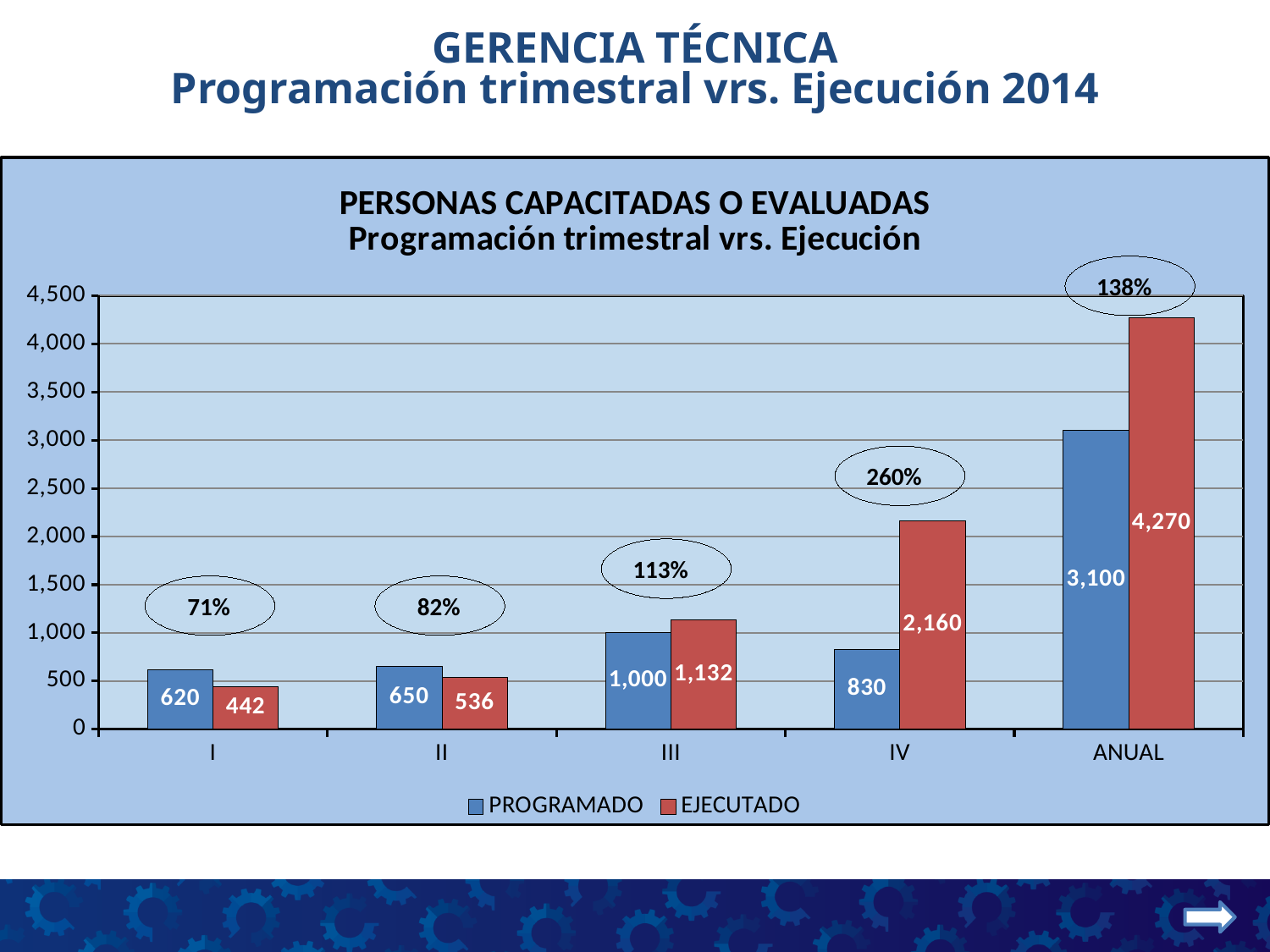
What kind of chart is shown? bar chart Which category has the highest EJECUTADO value? ANUAL For quarter II, which is larger, PROGRAMADO or EJECUTADO? PROGRAMADO What percentage is shown in the oval above quarter IV? 260% How many series does the legend list? 2 How many categories are shown on the x axis? 5 What is the difference between the EJECUTADO and PROGRAMADO values for quarter IV? 1,330 What is the EJECUTADO value for ANUAL? 4,270 What is the PROGRAMADO value for quarter III? 1,000 What is the EJECUTADO value for quarter IV? 2,160 Is the PROGRAMADO value for ANUAL greater or less than 3,000? greater Which category has the lowest EJECUTADO value? I